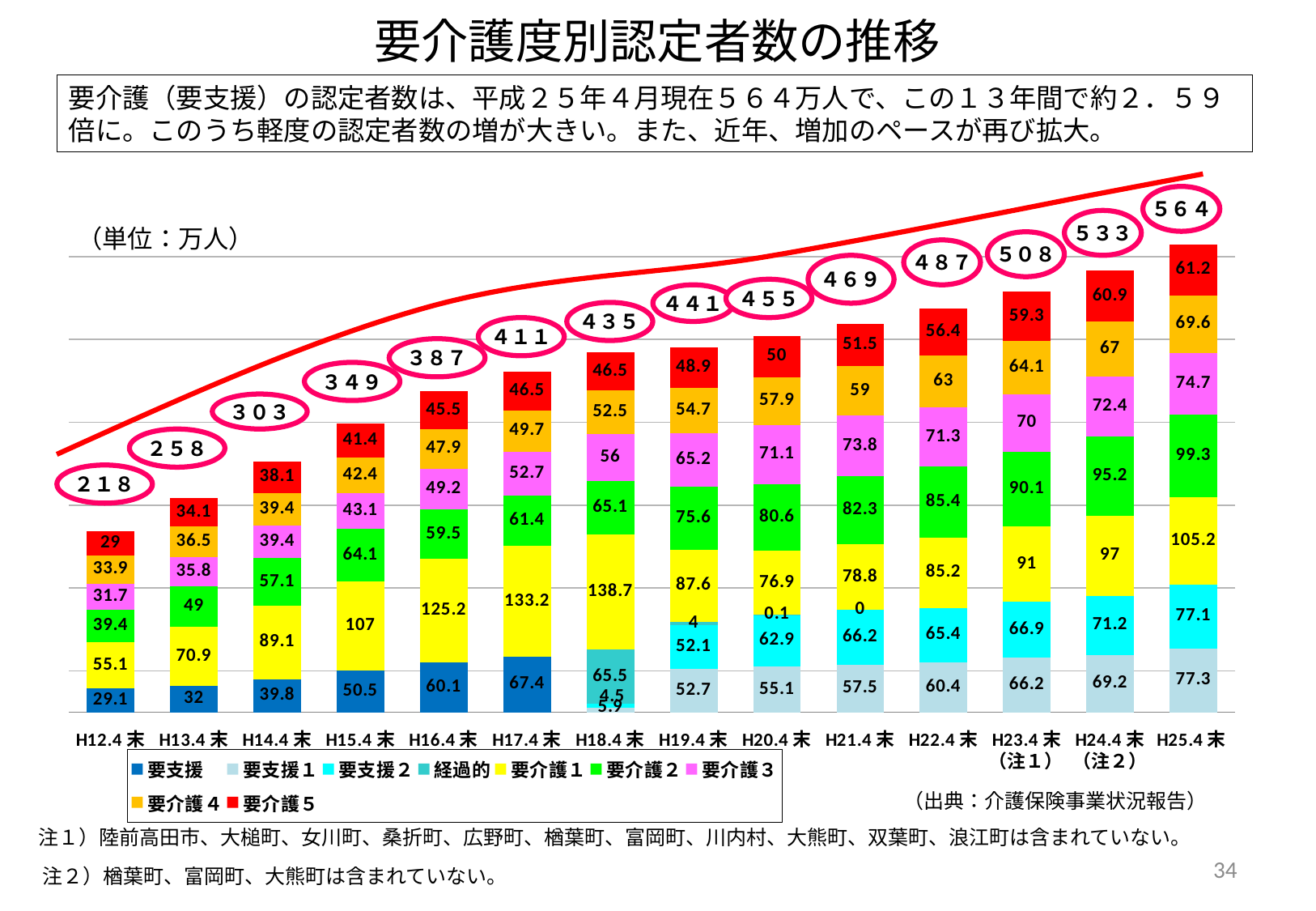
What is the total number of certified persons shown for H25.4末? 564 What is the value for 要介護3 at H24.4末? 72.4 Which time point has the lowest total number of certified persons? H12.4末 How many time points (categories) are plotted along the x axis? 14 Is the value for 要介護1 larger at H18.4末 or at H25.4末? H18.4末 What is the difference between the total for H25.4末 and the total for H12.4末? 346 How many series does the legend list? 9 What is the value for 要介護2 at H18.4末? 65.1 What is the value for 要介護5 at H12.4末? 29 What is the value for 要介護1 at H25.4末? 105.2 Which time point has the highest total number of certified persons? H25.4末 What kind of chart is shown on the slide? stacked bar chart